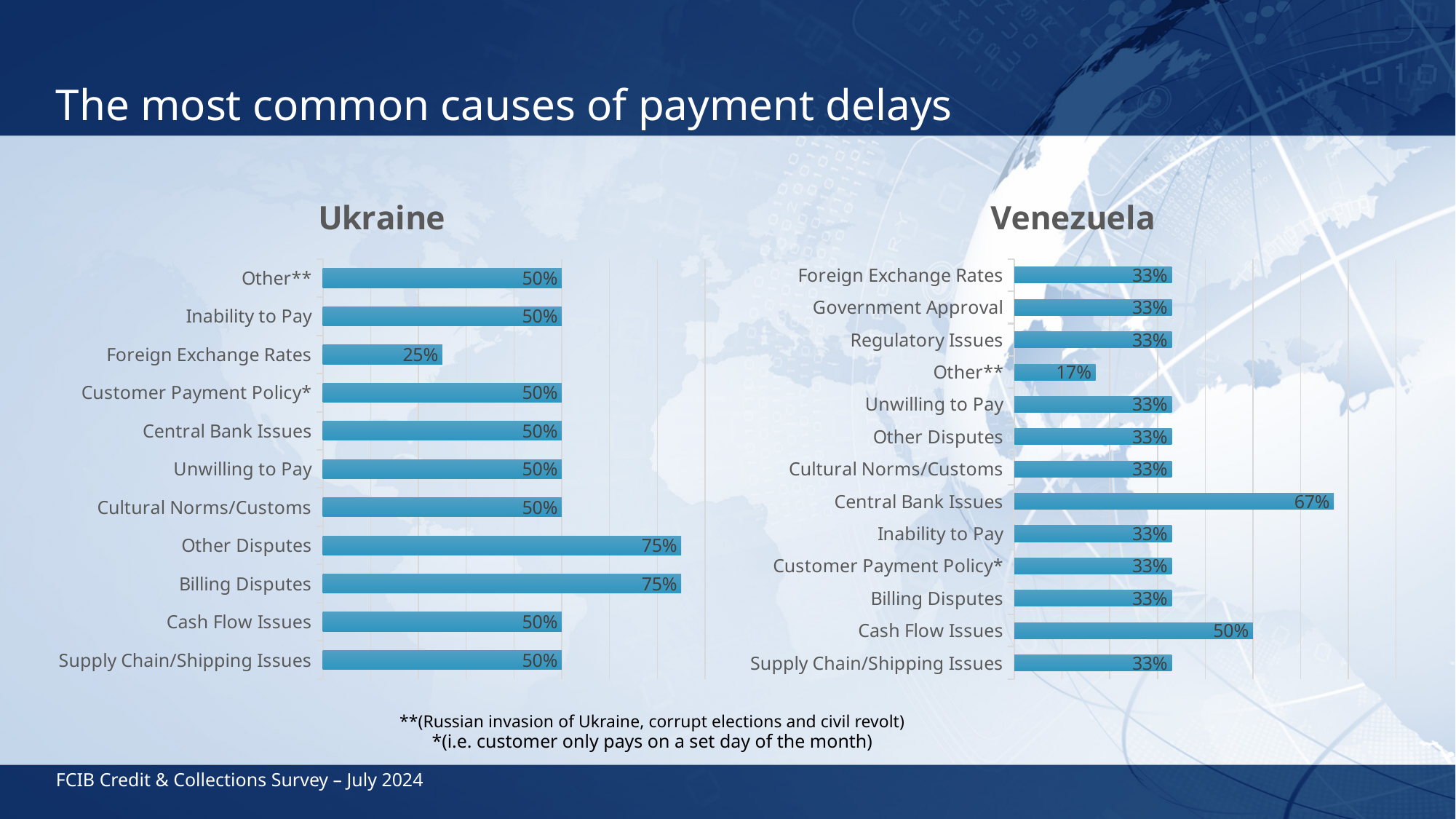
In the Venezuela chart, which category has the highest value? Central Bank Issues In the Venezuela chart, what is the difference between Central Bank Issues and Cash Flow Issues? 17% In the Ukraine chart, what is the value for Billing Disputes? 75% Which is larger: Cash Flow Issues in the Ukraine chart or Cash Flow Issues in the Venezuela chart? They are equal (50%) What kind of chart is the Ukraine chart? Bar chart In the Ukraine chart, what is the value for Foreign Exchange Rates? 25% In the Venezuela chart, which category has the lowest value? Other** In the Venezuela chart, what is the value for Central Bank Issues? 67% In the Ukraine chart, what is the difference between Other Disputes and Foreign Exchange Rates? 50% In the Venezuela chart, what is the value for Other**? 17% In the Ukraine chart, which category has the lowest value? Foreign Exchange Rates How many categories are shown in the Venezuela chart? 13